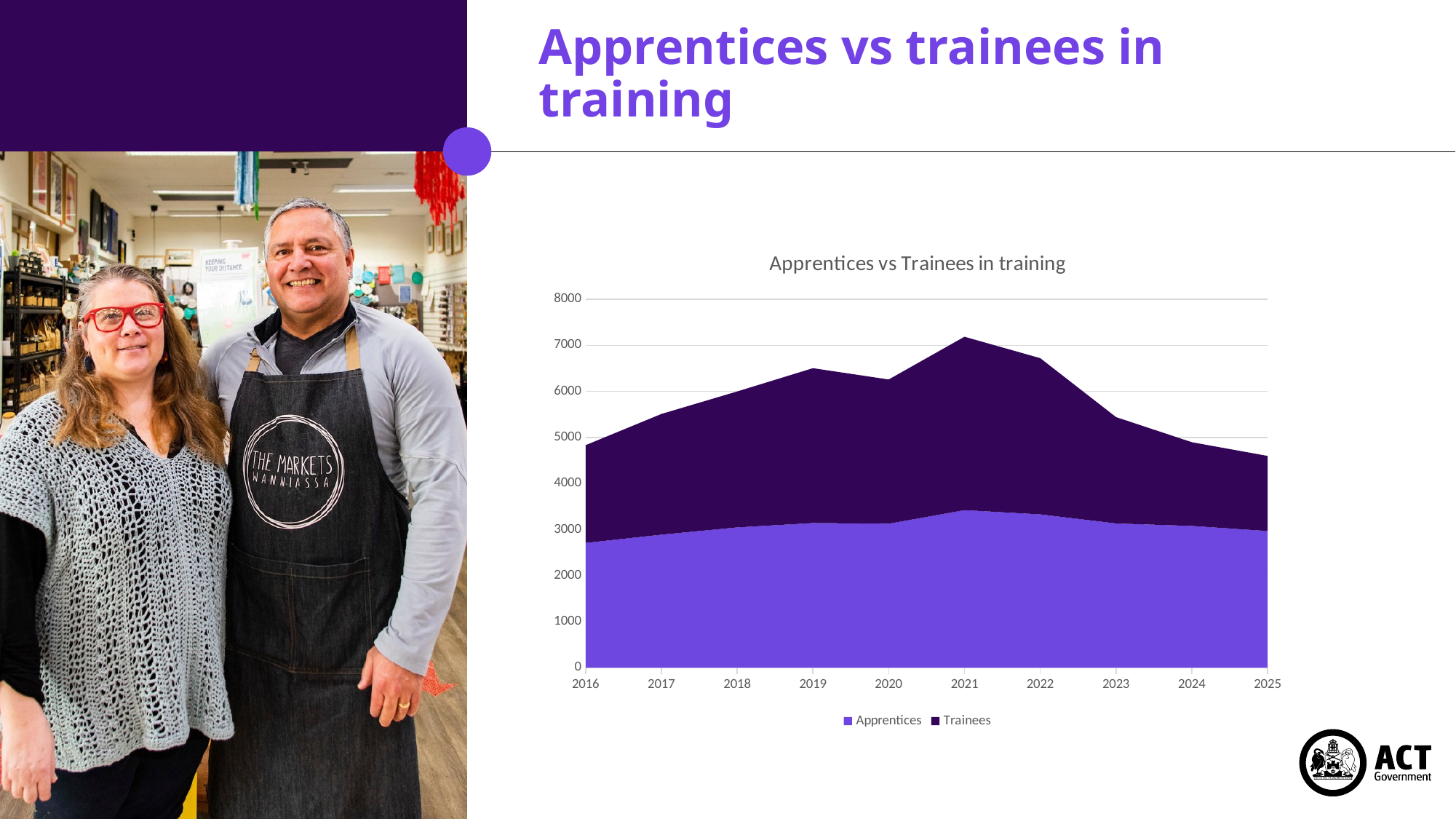
Is the value for Apprentices in 2021 greater or less than 3000? greater Is the combined total of apprentices and trainees in 2021 greater or less than 7000? greater What kind of chart is shown on the slide? Area chart What is the title of the chart? Apprentices vs Trainees in training Which series is shown in the darker purple colour in the chart? Trainees How many years are plotted along the x axis of the chart? 10 Is the value for Apprentices in 2016 greater or less than 3000? less Does the combined total of apprentices and trainees rise or fall from 2021 to 2025? fall In which year is the combined total of apprentices and trainees in training lowest? 2025 In which year is the combined total of apprentices and trainees in training highest? 2021 How many series does the chart legend list? 2